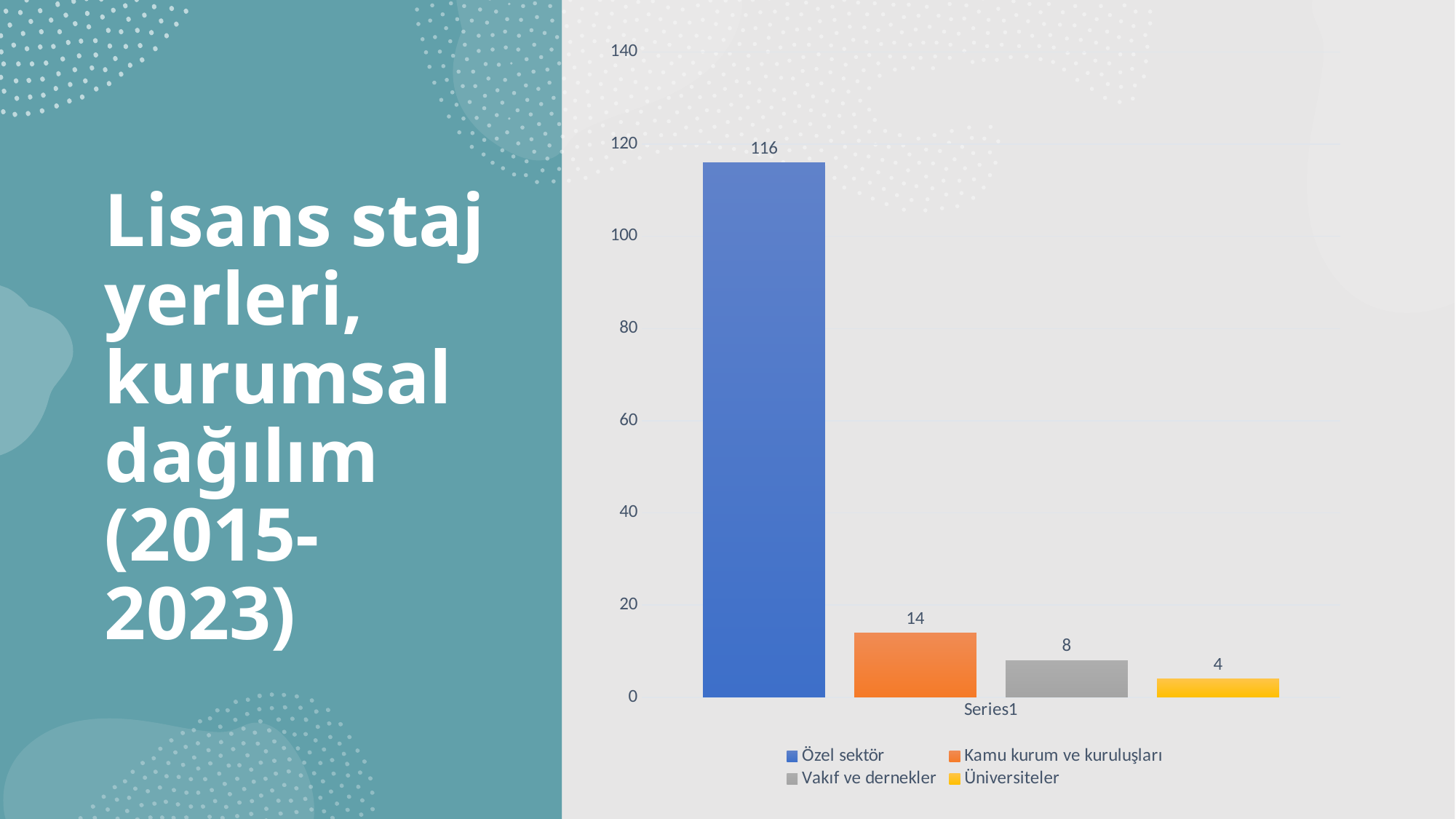
What is the value for Üniversiteler? 4 How many series does the legend list? 4 What is the value for Kamu kurum ve kuruluşları? 14 What kind of chart is shown on the slide? Bar chart What is the difference between the values for Vakıf ve dernekler and Üniversiteler? 4 What is the value for Özel sektör? 116 Which category has the lowest value? Üniversiteler What is the difference between the values for Özel sektör and Kamu kurum ve kuruluşları? 102 Which category has the highest value? Özel sektör Which is larger, the value for Kamu kurum ve kuruluşları or the value for Vakıf ve dernekler? Kamu kurum ve kuruluşları What colour is the bar for Üniversiteler? Yellow What is the value for Vakıf ve dernekler? 8